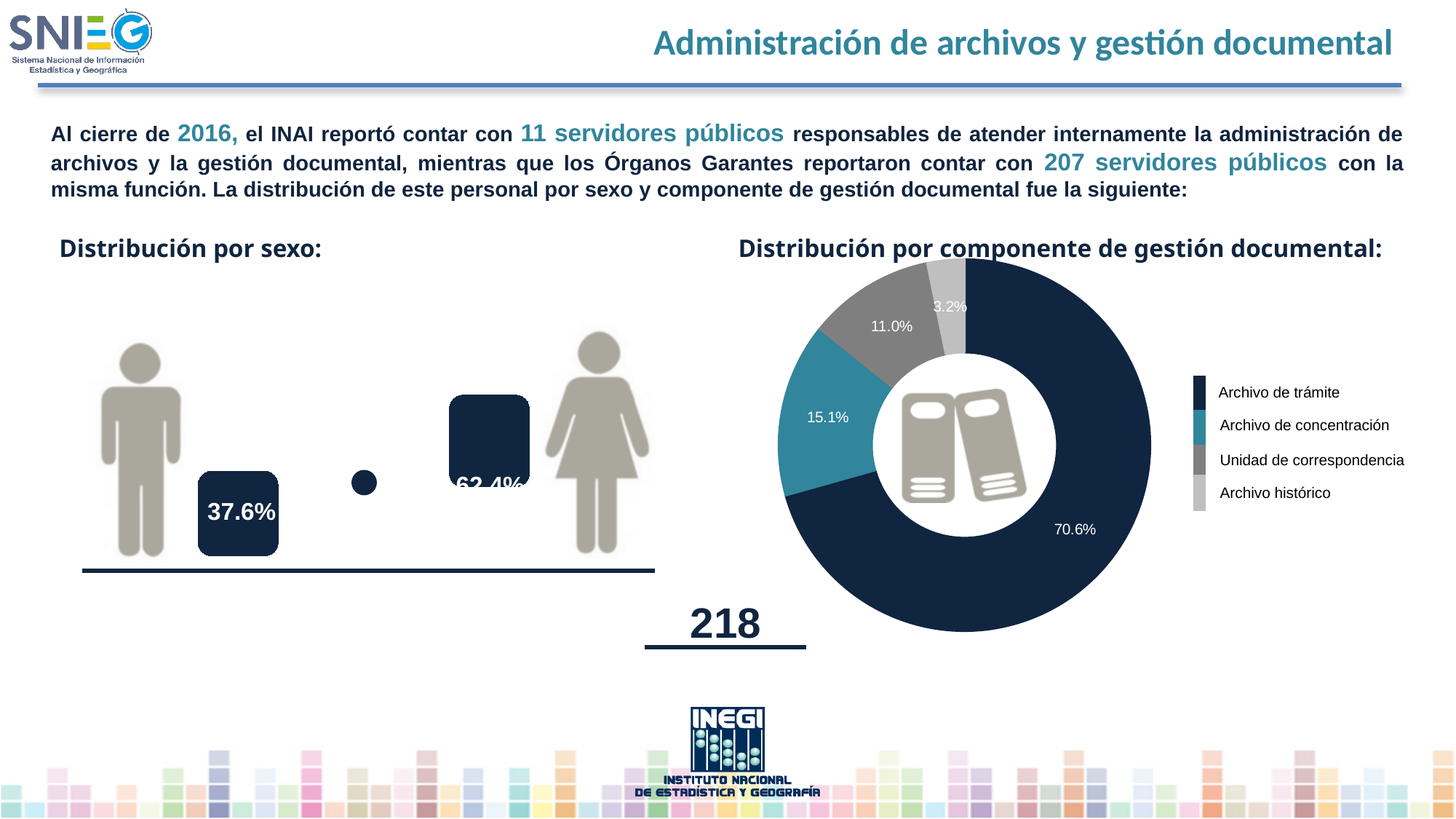
How many components are shown in the 'Distribución por componente de gestión documental' chart? 4 In the 'Distribución por componente de gestión documental' chart, which component has the largest share? Archivo de trámite In the 'Distribución por componente de gestión documental' chart, what percentage corresponds to Archivo de concentración? 15.1% In the 'Distribución por componente de gestión documental' chart, which component has the smallest share? Archivo histórico In the 'Distribución por componente de gestión documental' chart, by how many percentage points does Archivo de trámite exceed Archivo de concentración? 55.5 percentage points In the 'Distribución por componente de gestión documental' chart, what percentage corresponds to Unidad de correspondencia? 11.0% In the 'Distribución por componente de gestión documental' chart, what percentage corresponds to Archivo de trámite? 70.6% In the 'Distribución por componente de gestión documental' chart, which is larger: Archivo de concentración or Unidad de correspondencia? Archivo de concentración In the 'Distribución por componente de gestión documental' chart, what percentage corresponds to Archivo histórico? 3.2% In the 'Distribución por componente de gestión documental' chart, what colour represents Archivo de trámite? Dark navy blue In the 'Distribución por sexo' graphic, what percentage is shown next to the male figure? 37.6% What kind of chart is used for 'Distribución por componente de gestión documental'? Pie (donut) chart